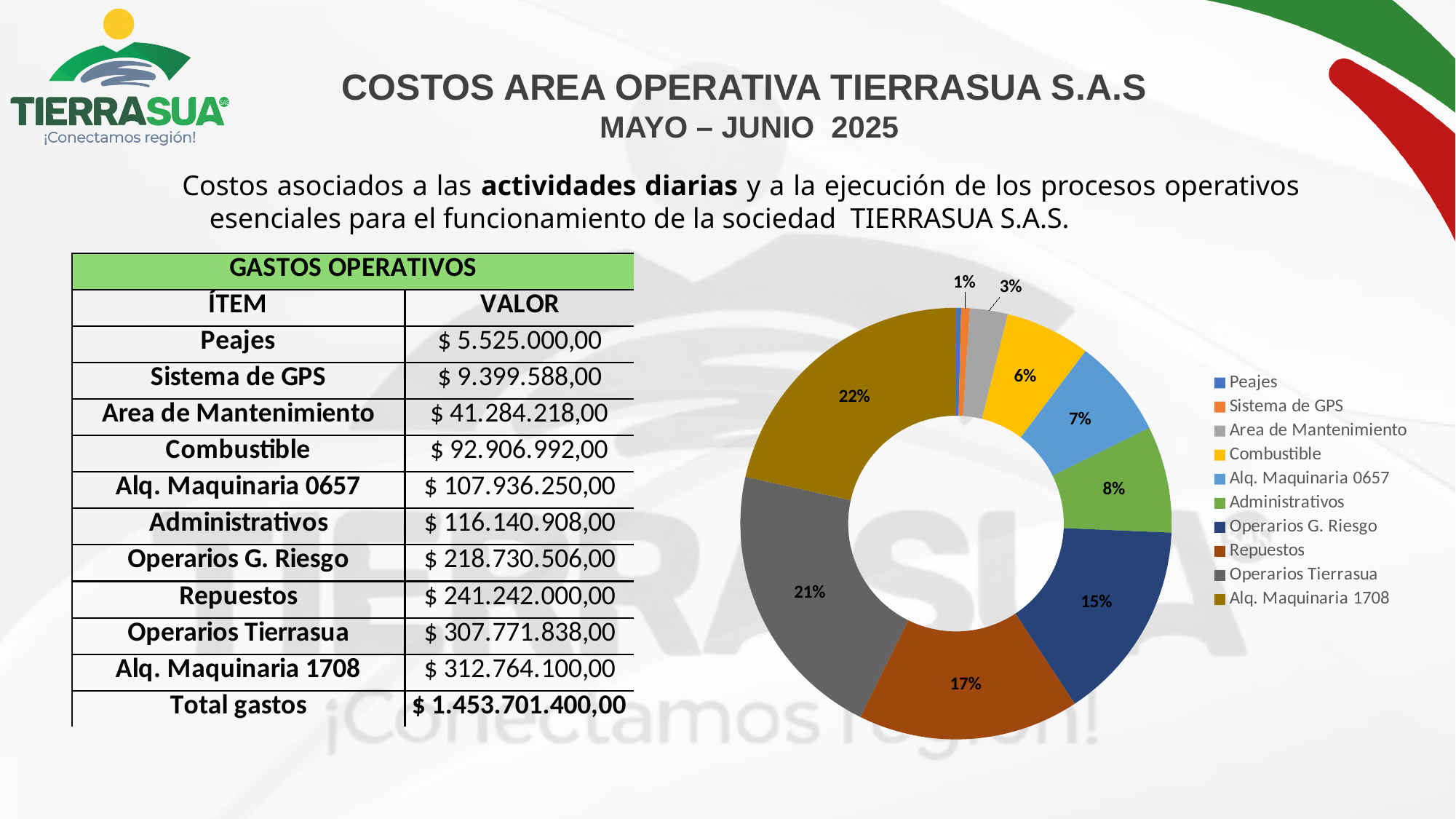
What kind of chart is shown on the slide? Doughnut (pie) chart What is the difference in percentage points between the Repuestos slice and the Combustible slice? 11 percentage points What colour is the Repuestos slice in the chart? Brown Which is larger in the chart, the slice for Administrativos or the slice for Alq. Maquinaria 0657? Administrativos How many entries does the chart legend list? 10 Which category has the largest slice in the chart? Alq. Maquinaria 1708 What share of the chart does Combustible represent? 6% What share of the chart does Operarios G. Riesgo represent? 15% What share of the chart does Alq. Maquinaria 1708 represent? 22%